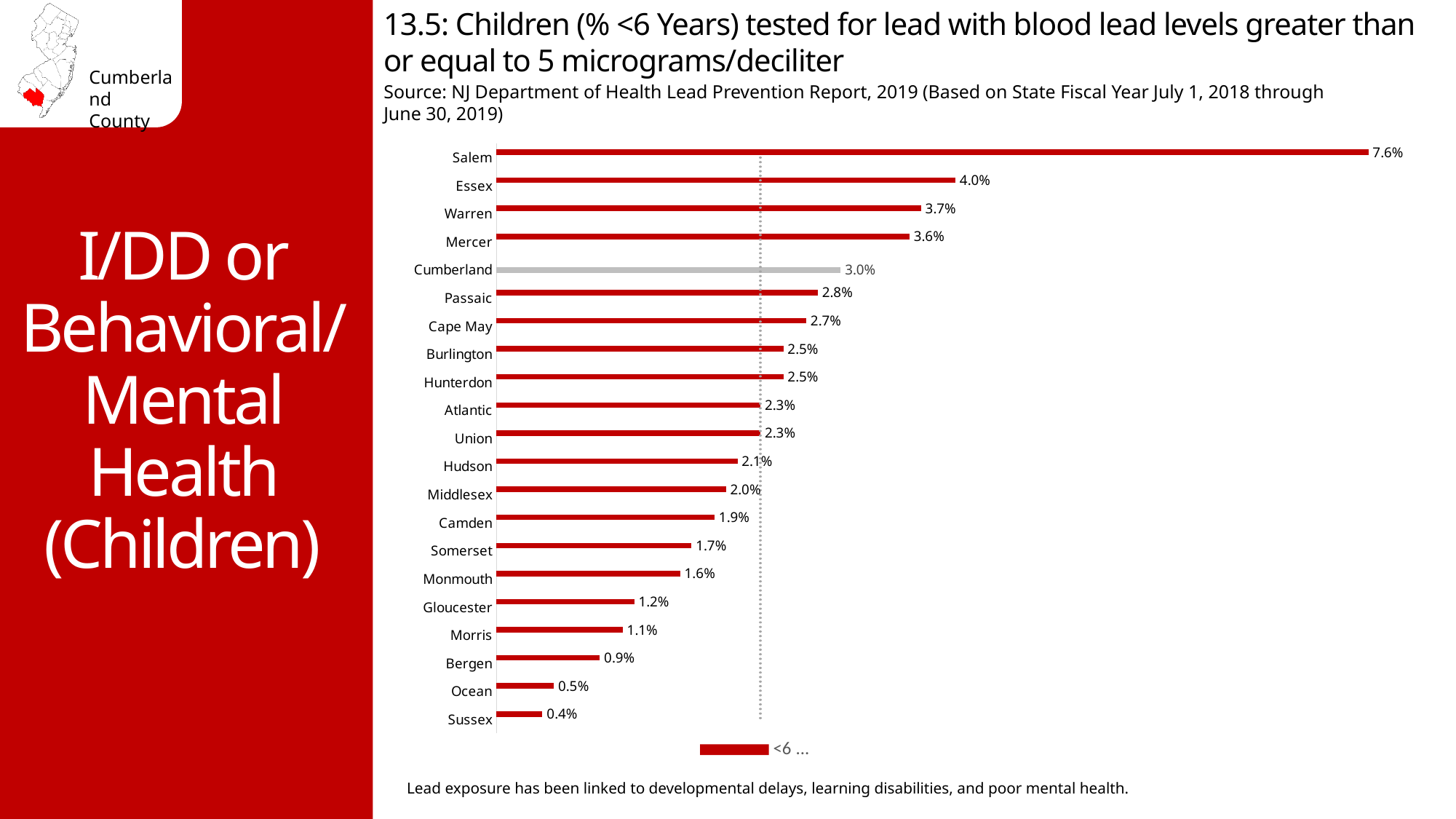
Which is larger, the value for Bergen or the value for Morris? Morris Which county has the highest value? Salem Which county has the lowest value? Sussex What is the difference between the values for Cumberland and Camden? 1.1% What kind of chart is shown on the slide? Bar chart What is the value for Salem? 7.6% Which is larger, the value for Warren or the value for Mercer? Warren What is the difference between the values for Salem and Essex? 3.6% How many counties are shown in the chart? 21 What is the value for Cumberland? 3.0% Which county's bar is shown in grey rather than red? Cumberland What is the value for Gloucester? 1.2%